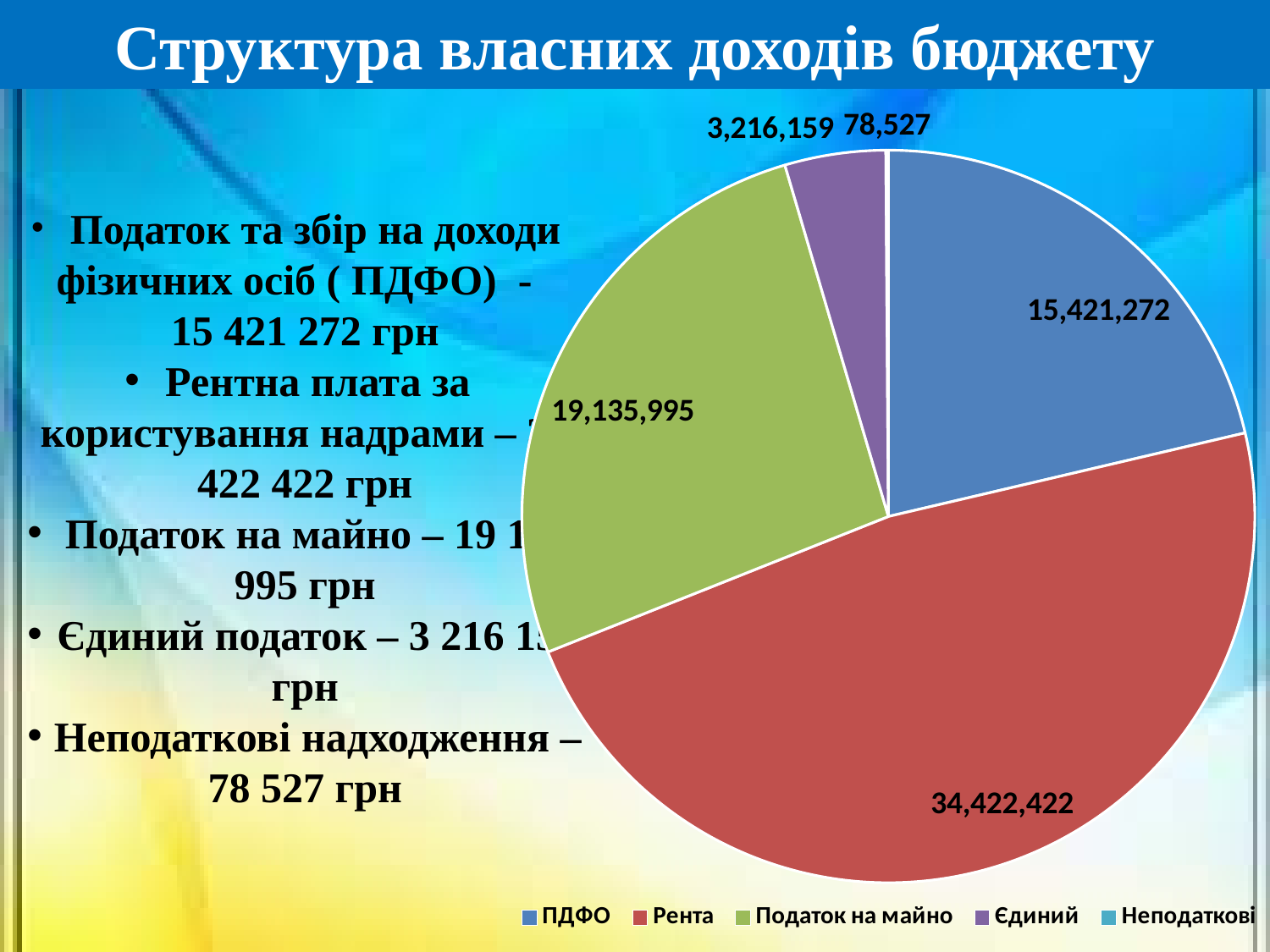
What is the value of the Єдиний slice? 3,216,159 What is the title of the slide containing the chart? Структура власних доходів бюджету What is the value of the Податок на майно slice? 19,135,995 What kind of chart is shown on the slide? pie chart Which category has the largest slice of the pie? Рента How many slices does the pie chart have? 5 Which category has the smallest slice of the pie? Неподаткові What is the value of the Рента slice? 34,422,422 Which is larger, the Податок на майно slice or the ПДФО slice? Податок на майно What is the difference between the Рента value and the ПДФО value? 19,001,150 What is the value of the Неподаткові slice? 78,527 What is the value of the ПДФО slice? 15,421,272